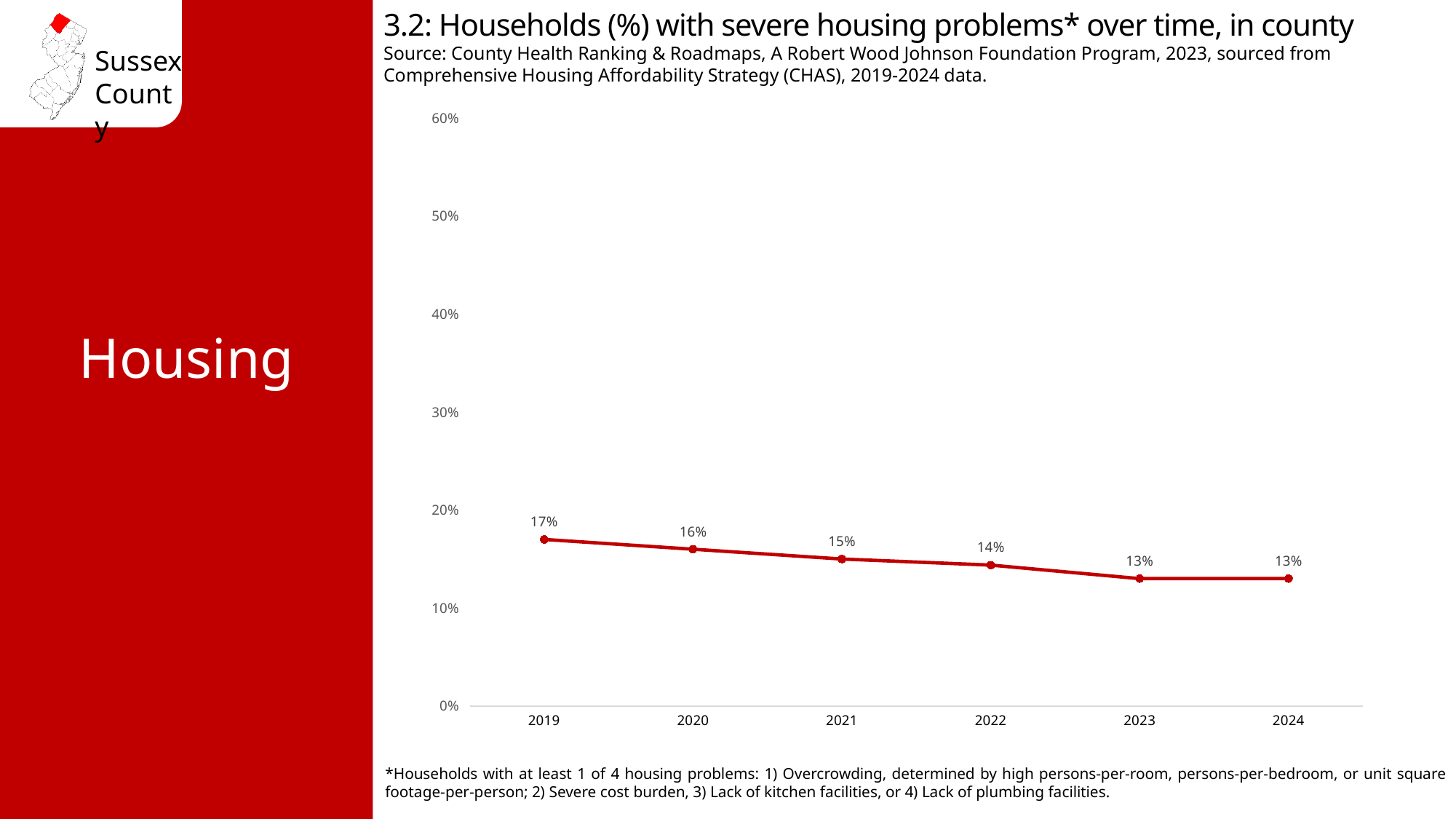
What kind of chart is shown on the slide? Line chart What is the difference between the 2019 value and the 2024 value? 4 percentage points Is the value for 2021 greater or less than 20%? less What is the highest value shown on the vertical axis? 60% What is the difference between the 2020 value and the 2023 value? 3 percentage points Which year has the highest percentage of households with severe housing problems? 2019 Do the values rise or fall from 2019 to 2024? Fall What is the value shown for 2024? 13% Which is larger, the value for 2020 or the value for 2022? 2020 What percentage of households had severe housing problems in 2019? 17% What is the value shown for 2022? 14% How many years are plotted on the chart? 6